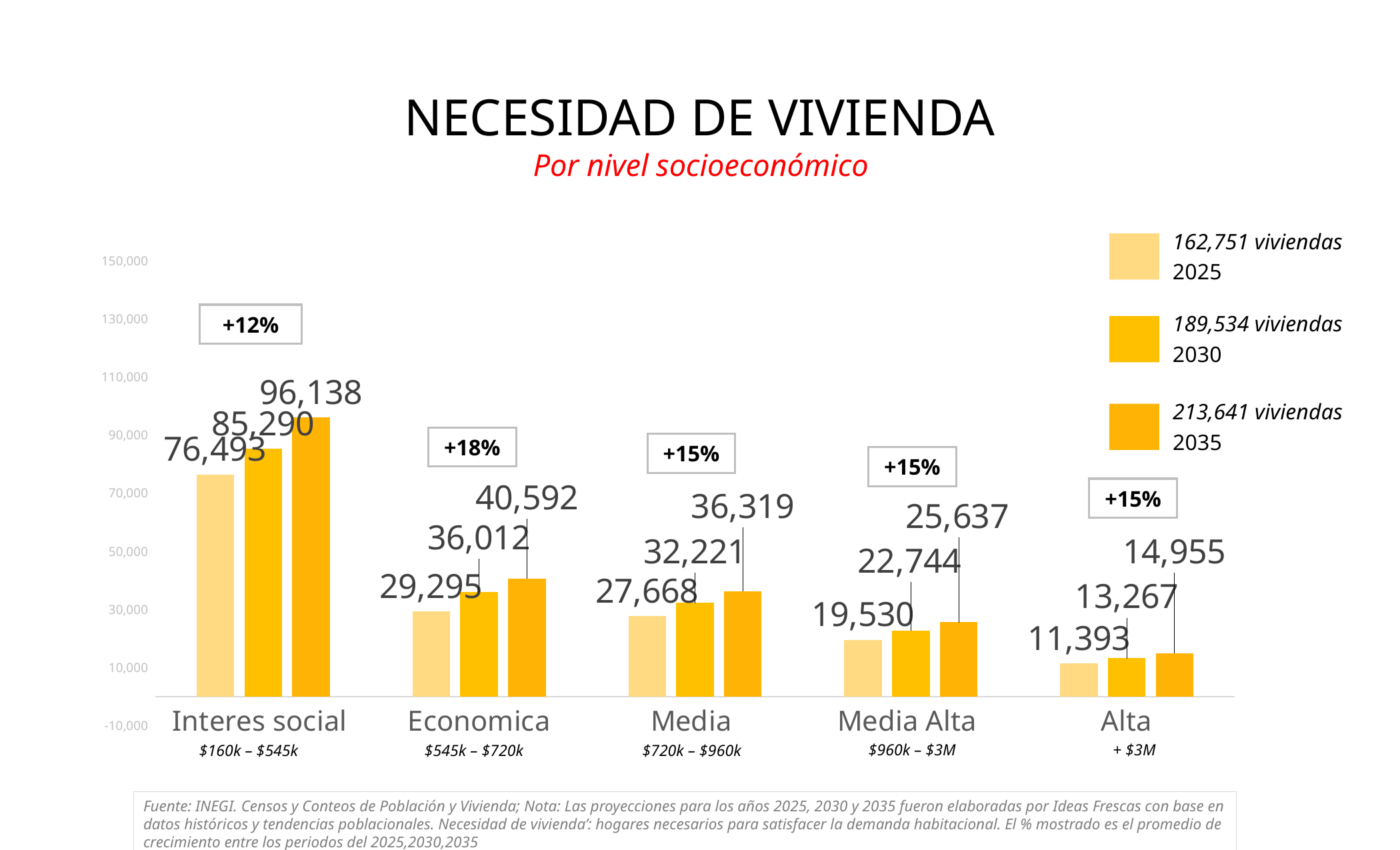
What is the 2035 value for Economica? 40,592 What is the 2025 value for Alta? 11,393 What is the 2030 value for Media Alta? 22,744 Which is larger: the 2030 value for Economica or the 2035 value for Media? 2035 value for Media What is the difference between the 2035 and 2030 values for Media? 4,098 What is the difference between the 2035 and 2025 values for Interes social? 19,645 Which category has the highest 2035 value? Interes social Which category has the lowest 2025 value? Alta How many categories are shown on the x axis? 5 How many series does the legend list? 3 What is the 2025 value for Interes social? 76,493 What kind of chart is shown on the slide? Bar chart